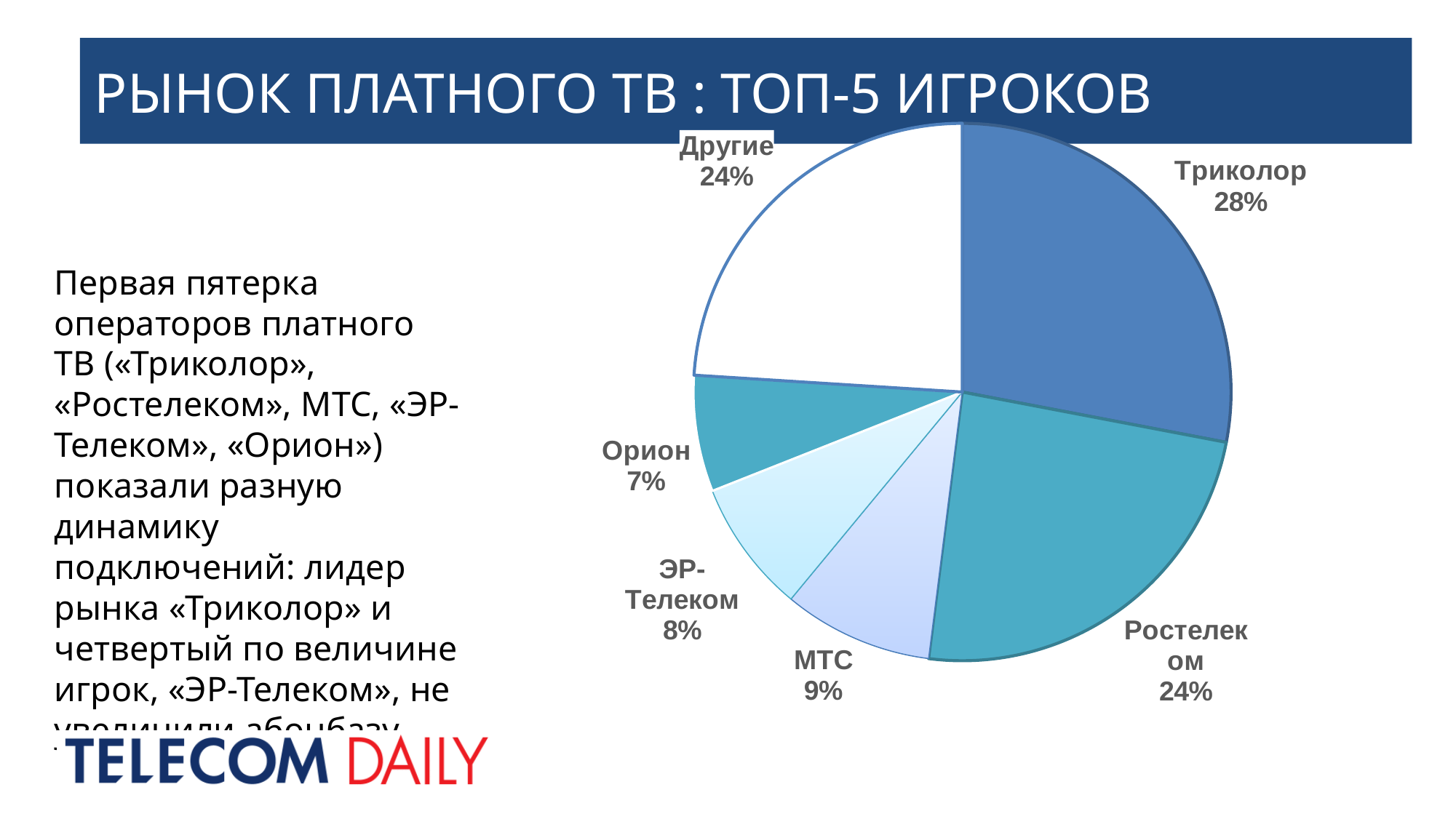
What is the value shown for МТС? 9% What is the value shown for Орион? 7% Which is larger, the share for МТС or the share for ЭР-Телеком? МТС What is the value shown for Ростелеком? 24% How many slices does the pie chart have? 6 What share of the pie is labelled Другие? 24% What is the difference in percentage points between Триколор and Ростелеком? 4 What kind of chart is shown on the slide? Pie chart Which slice of the pie is the largest? Триколор What is the value shown for ЭР-Телеком? 8% Which slice of the pie is the smallest? Орион What share of the pie does Триколор hold? 28%